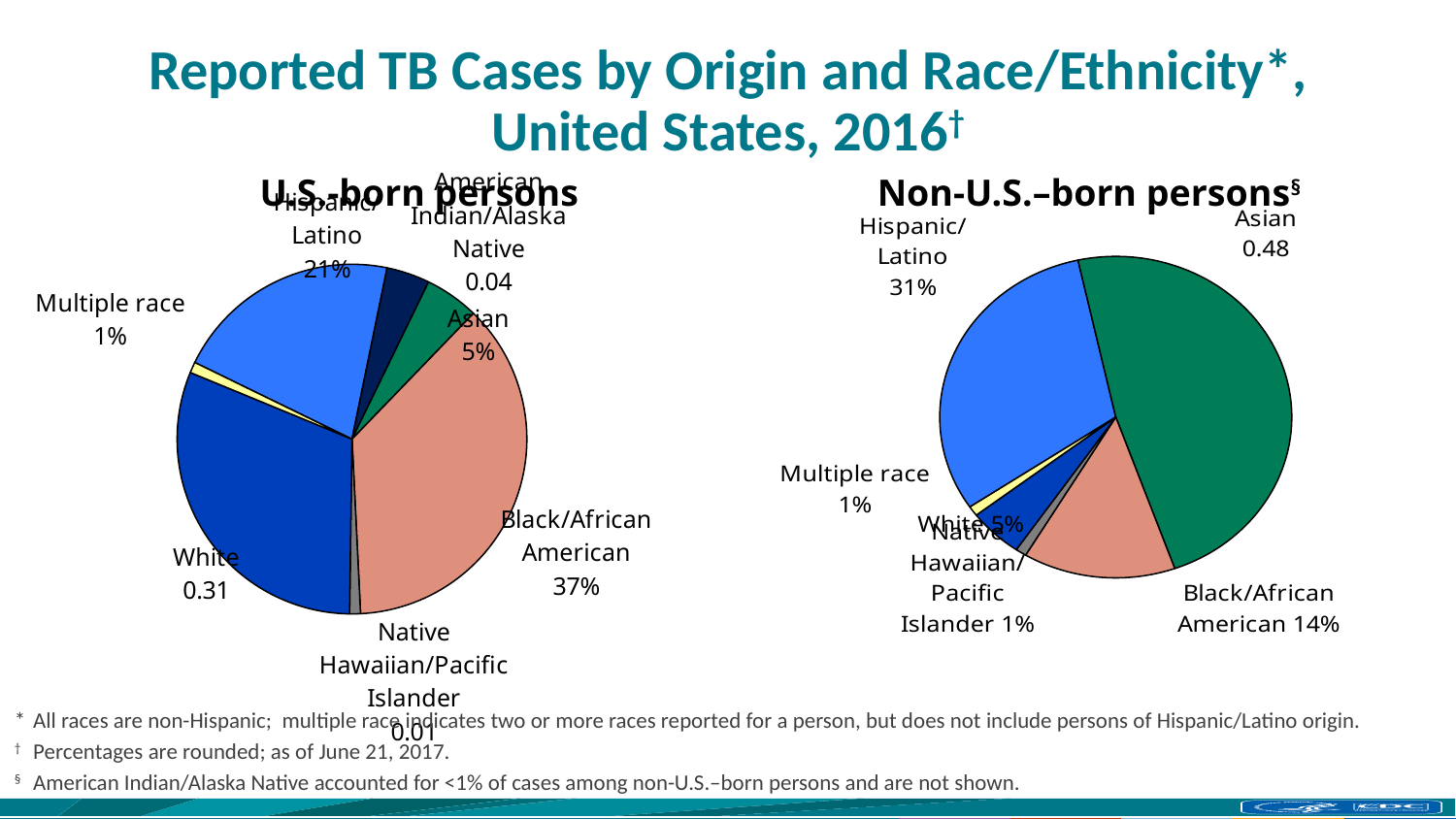
In the U.S.-born persons chart, which race/ethnicity has the largest share? Black/African American In the U.S.-born persons chart, what share of cases is Black/African American? 37% In the U.S.-born persons chart, what is the difference between the Black/African American share and the Hispanic/Latino share? 16% In the Non-U.S.-born persons chart, which race/ethnicity has the largest share? Asian In the Non-U.S.-born persons chart, what share of cases is Hispanic/Latino? 31% In the U.S.-born persons chart, what value is shown for Hispanic/Latino? 21% How many slices does the Non-U.S.-born persons pie chart have? 6 In the Non-U.S.-born persons chart, what value is shown for Asian? 0.48 In the U.S.-born persons chart, what value is shown for White? 0.31 In the Non-U.S.-born persons chart, what share of cases is Black/African American? 14% What type of chart is used for the U.S.-born persons data? Pie chart